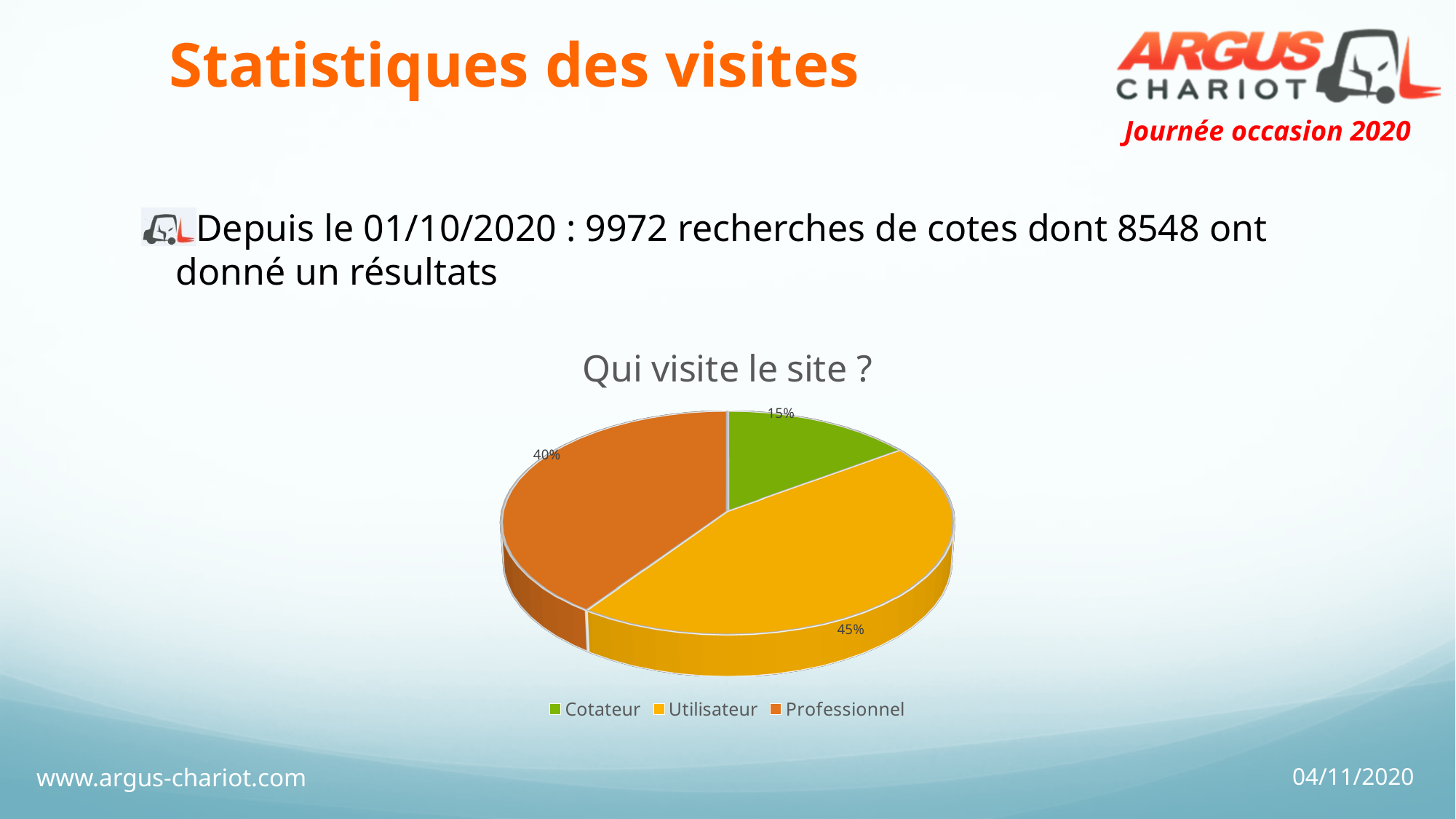
How many categories does the pie chart show? 3 What is the difference in percentage points between Utilisateur and Professionnel? 5 Which category has the largest slice of the pie? Utilisateur Which is larger, the share for Professionnel or the share for Cotateur? Professionnel What is the difference in percentage points between Utilisateur and Cotateur? 30 Which category has the smallest slice of the pie? Cotateur What is the title of the chart? Qui visite le site ? What share of the pie does Professionnel have? 40% What share of the pie does Cotateur have? 15% What kind of chart is shown on the slide? Pie chart Which colour represents Cotateur in the legend? Green What share of the pie does Utilisateur have? 45%